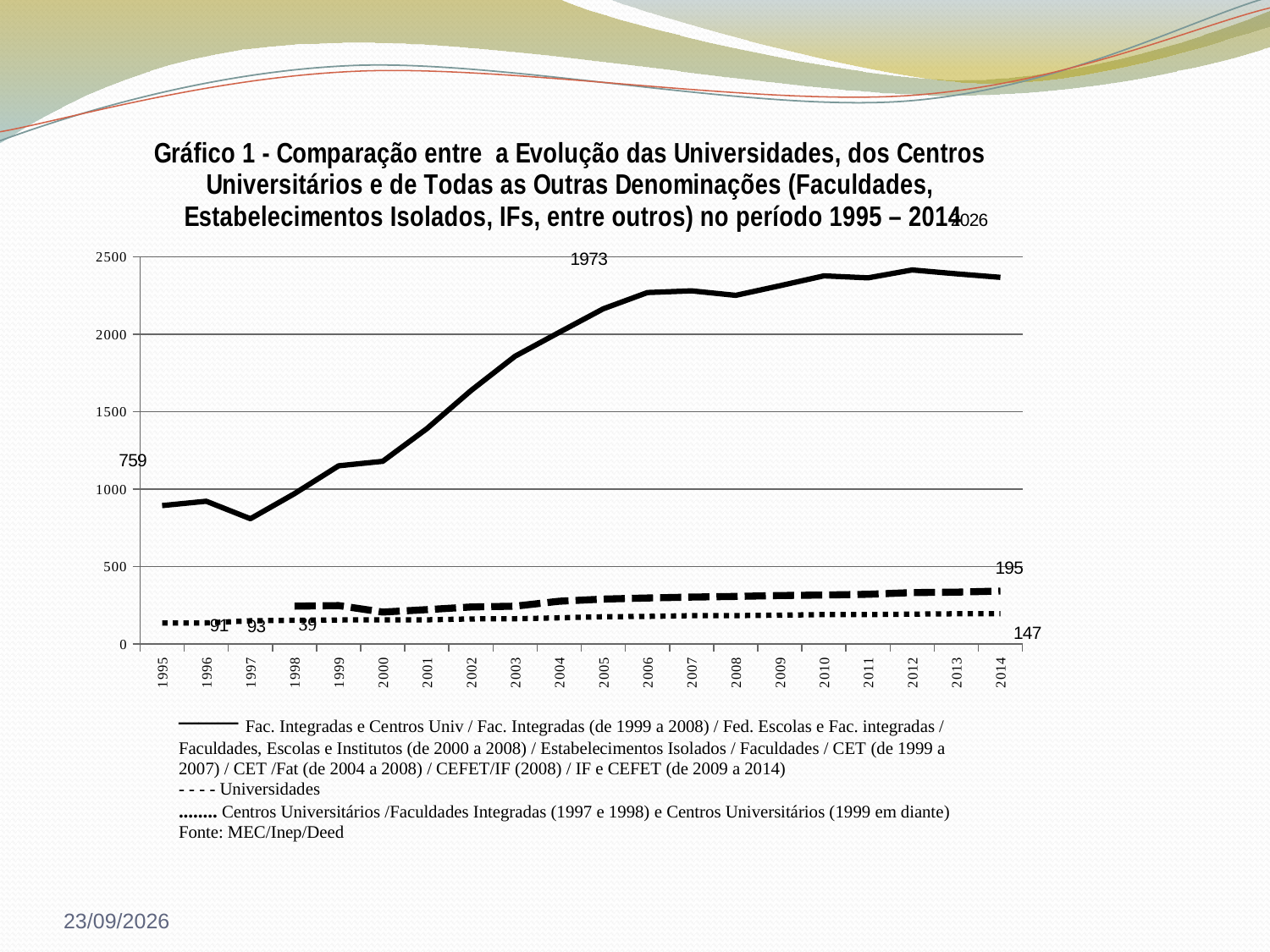
Is the value of the dashed line (Universidades) in 2014 greater or less than 500? less What is the first year shown on the x axis? 1995 Is the value of the solid line in 2014 greater or less than 2000? greater In which year does the solid line reach its lowest value? 1997 How many series does the legend list? 3 What kind of chart is shown on the slide? line chart Does the solid line (Fac. Integradas e Centros Univ / ... IF e CEFET) generally rise or fall from 1995 to 2014? rise Is the value of the solid line in 1995 greater or less than 1000? less In 2010, which series has the larger value: the solid line or the dashed line (Universidades)? the solid line How many years are shown along the x axis? 20 Which line style represents Universidades in the legend? dashed line